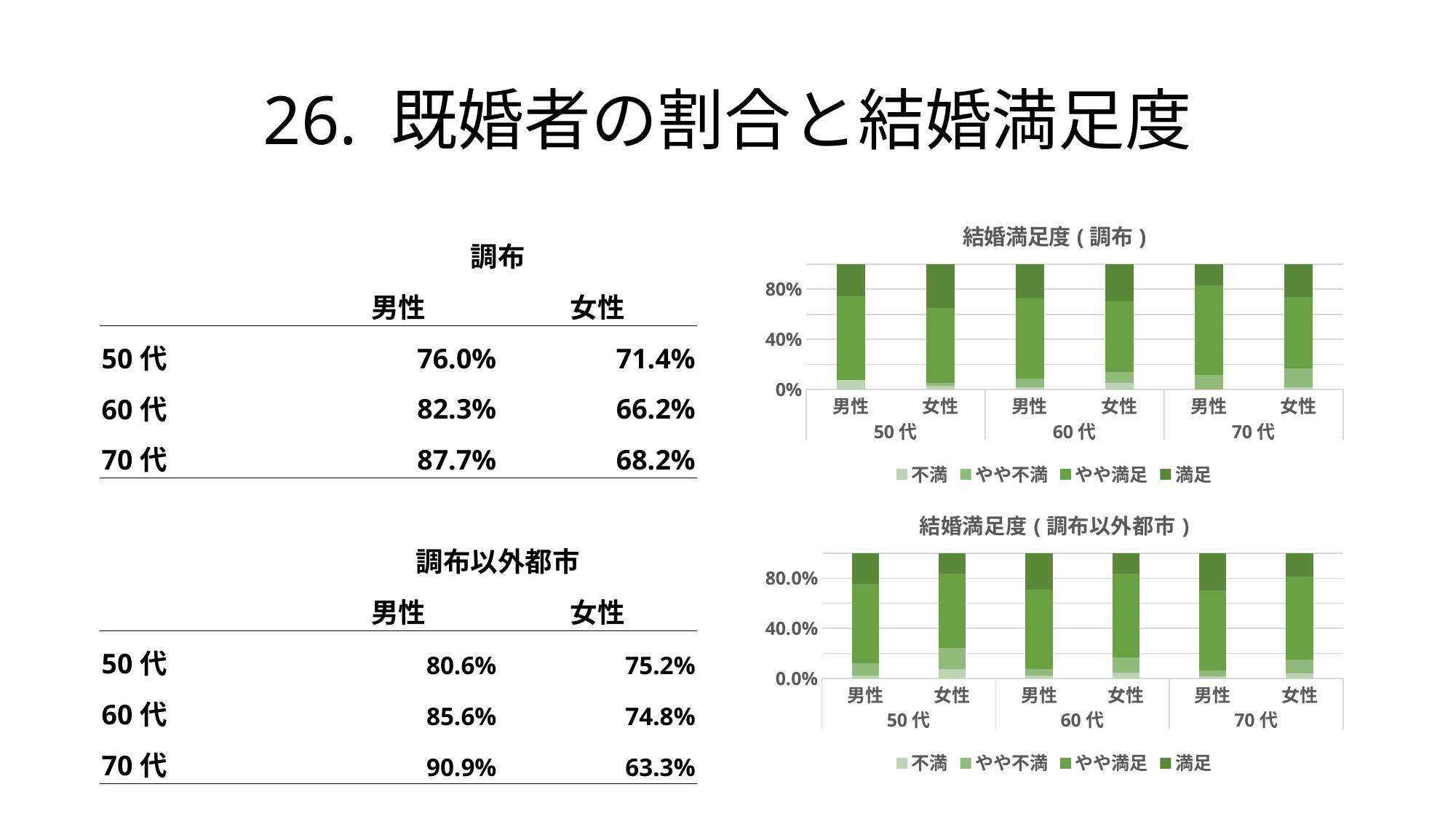
What kind of chart is the chart titled 結婚満足度（調布）? stacked bar chart In the chart titled 結婚満足度（調布）, is the top of the やや満足 segment for 女性 in 50代 greater or less than 80%? less In the chart titled 結婚満足度（調布以外都市）, is the top of the やや満足 segment for 男性 in 70代 greater or less than 80.0%? less How many bars are plotted in the chart titled 結婚満足度（調布）? 6 What is the highest tick label shown on the y axis of the chart titled 結婚満足度（調布）? 80% What is the title of the lower chart on the right side of the slide? 結婚満足度（調布以外都市） How many age groups are shown on the x axis of the chart titled 結婚満足度（調布以外都市）? 3 In the chart titled 結婚満足度（調布）, which bar in 50代 has the larger 満足 segment, 男性 or 女性? 女性 In the chart titled 結婚満足度（調布以外都市）, which bar in 50代 has the larger combined 不満 and やや不満 share, 男性 or 女性? 女性 How many series does the legend of the chart titled 結婚満足度（調布）list? 4 What are the legend entries of the chart titled 結婚満足度（調布以外都市）? 不満, やや不満, やや満足, 満足 In the chart titled 結婚満足度（調布以外都市）, is the top of the やや不満 segment for 女性 in 50代 greater or less than 40.0%? less